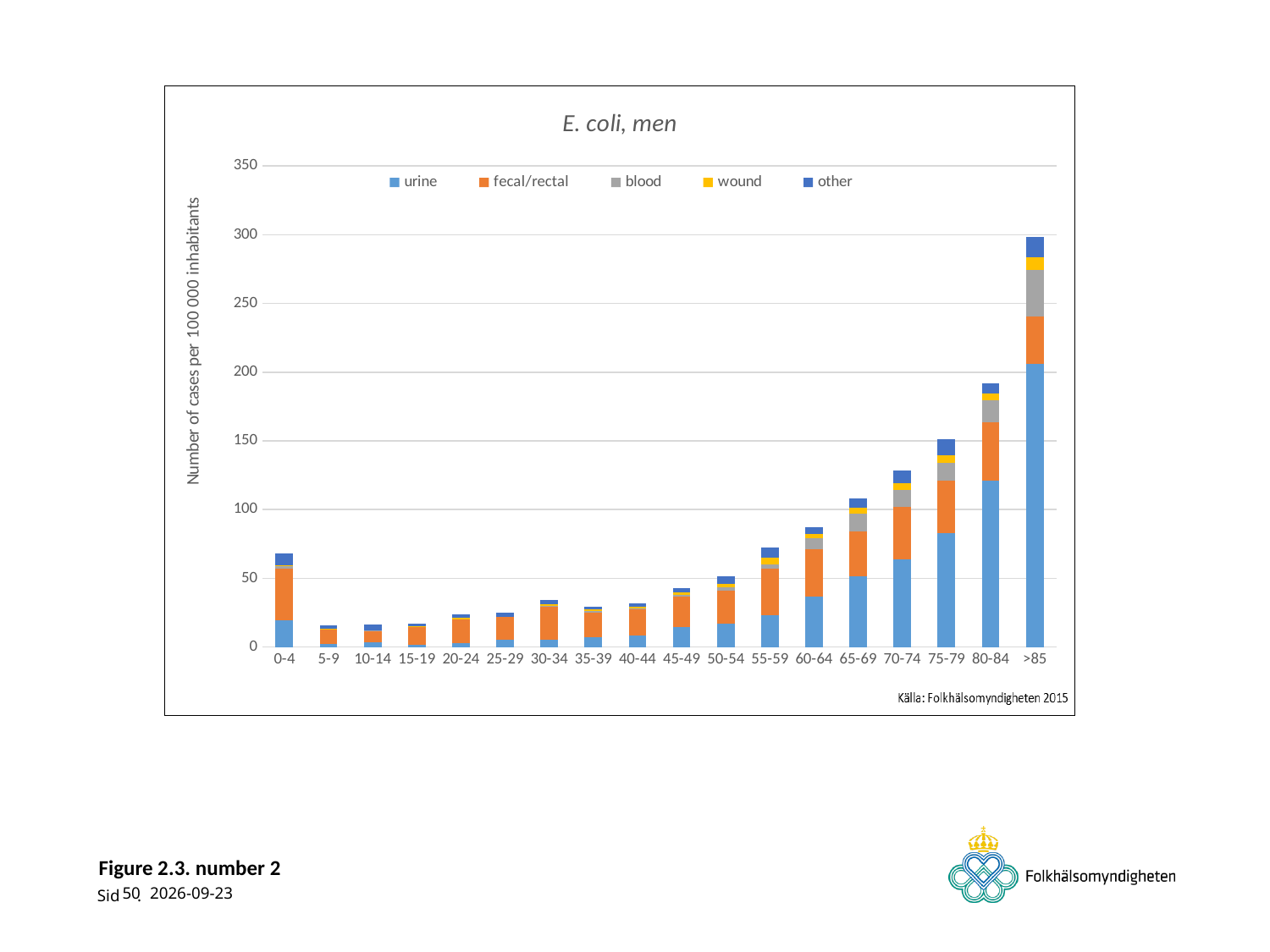
Is the total value for the 60-64 age group greater or less than 100? less Is the total value for the 80-84 age group greater or less than 150? greater From the 5-9 age group to the >85 age group, do the bar totals generally rise or fall? rise How many series does the legend list? 5 What is the label of the y axis? Number of cases per 100 000 inhabitants What kind of chart is shown on the slide? stacked bar chart Is the total value for the 0-4 age group greater or less than 50? greater Which has a larger total, the 0-4 age group or the 5-9 age group? 0-4 What is the title of the chart? E. coli, men How many age-group categories are shown on the x axis? 18 Which age group has the highest total number of cases? >85